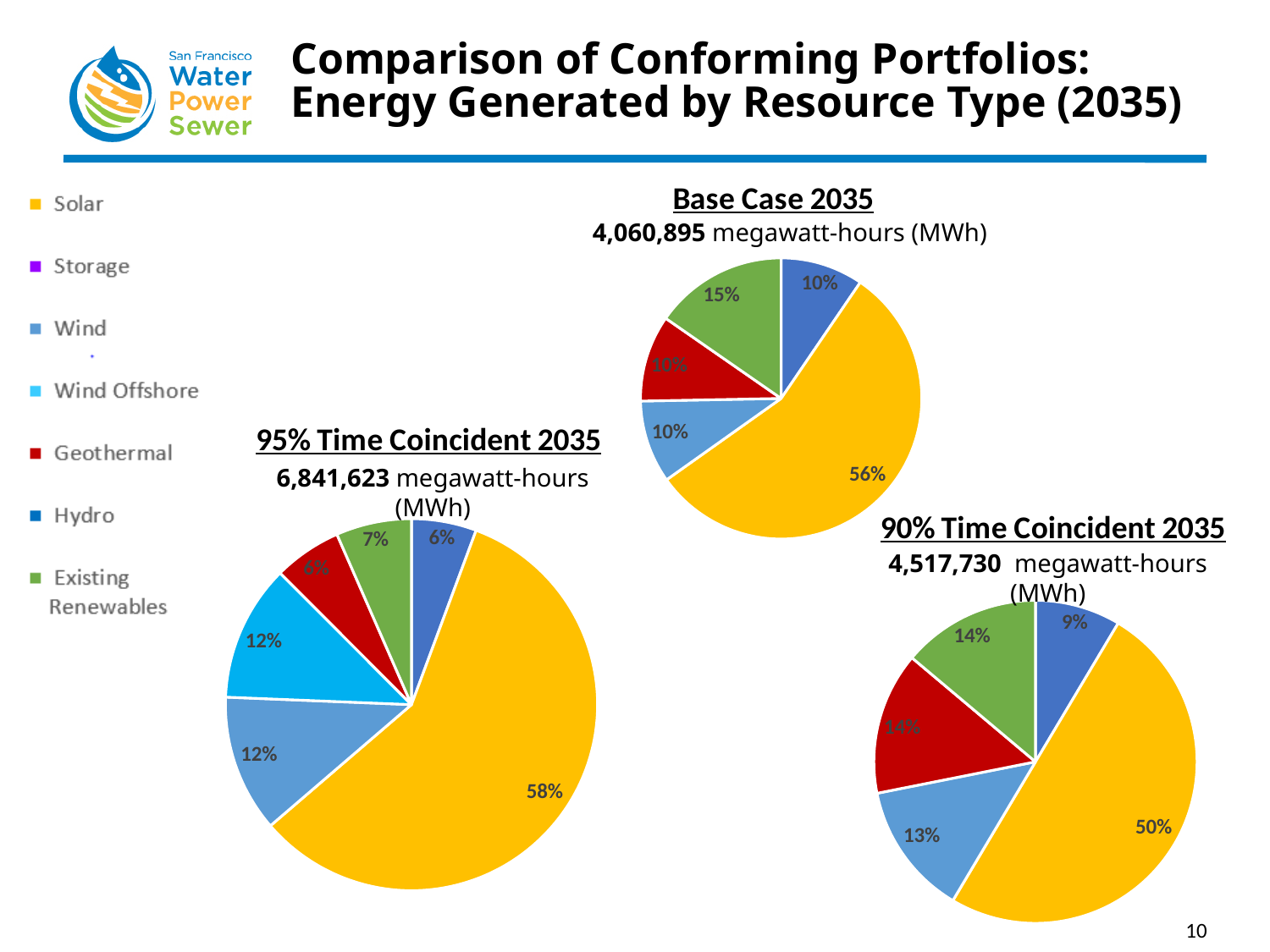
What is the difference between the Solar share in the 95% Time Coincident 2035 chart and the Solar share in the 90% Time Coincident 2035 chart? 8% In the 95% Time Coincident 2035 pie chart, which resource type has the largest share? Solar In the 95% Time Coincident 2035 pie chart, what share of energy comes from Wind Offshore? 12% In the Base Case 2035 pie chart, what share of energy is generated by Solar? 56% In the 90% Time Coincident 2035 pie chart, what share of energy comes from Wind? 13% How many resource types does the legend on the slide list? 7 In the Base Case 2035 pie chart, what share of energy comes from Existing Renewables? 15% In the 90% Time Coincident 2035 pie chart, what share of energy comes from Hydro? 9% What kind of chart is used to show the Base Case 2035 energy mix? Pie chart In the 90% Time Coincident 2035 pie chart, what share of energy is generated by Solar? 50% In the Base Case 2035 pie chart, which resource type has the largest share? Solar In the 95% Time Coincident 2035 pie chart, what share of energy is generated by Solar? 58%